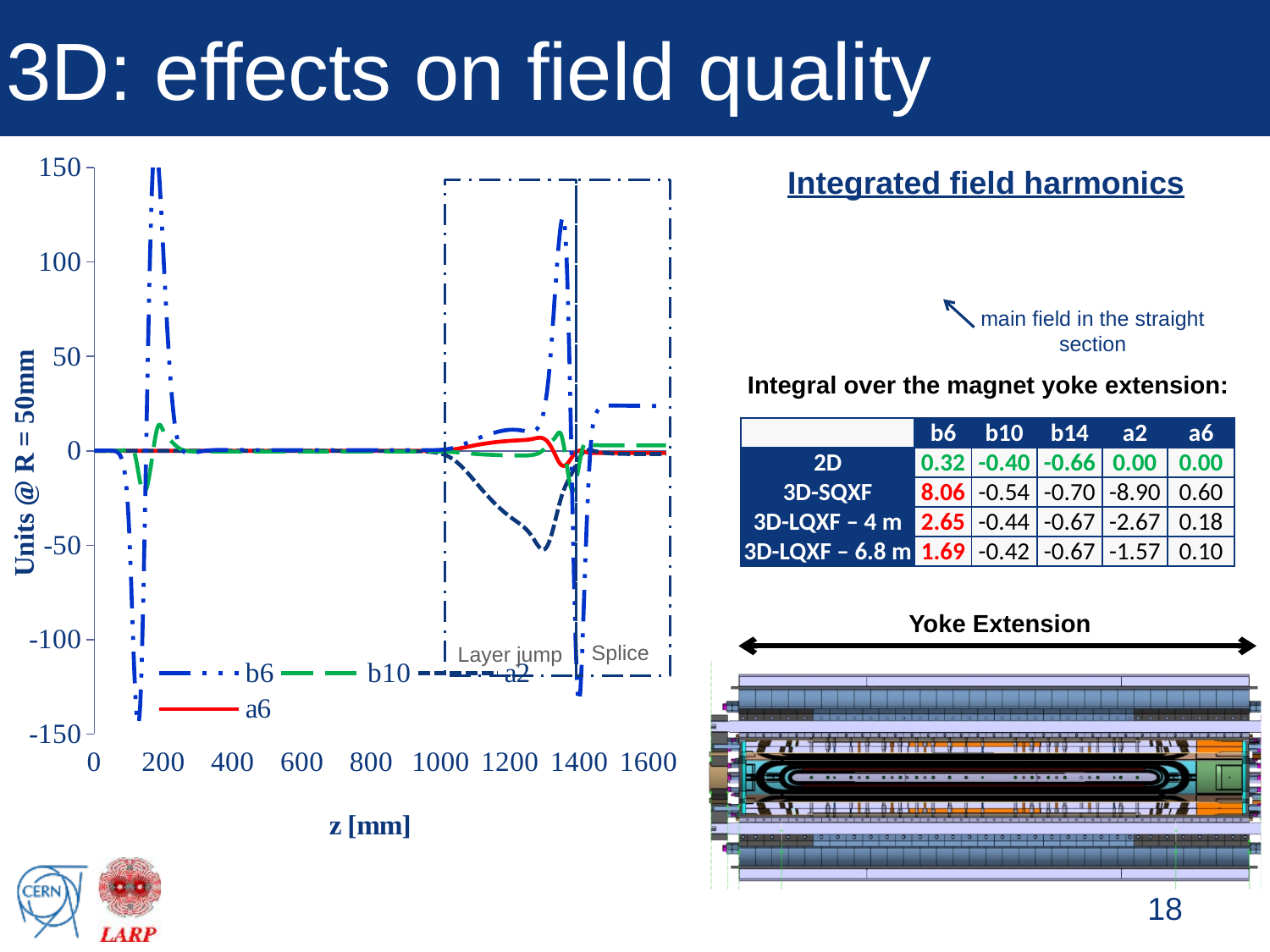
How many series does the legend of the chart list? 4 What kind of chart is shown on the left of the slide? line chart What is the label of the y axis of the chart? Units @ R = 50mm Which series has a larger magnitude peak near z = 1350 mm, b6 or a6? b6 Which series reaches the highest value on the chart? b6 Is the value of a2 at z = 1300 mm greater or less than 0? less Between z = 400 mm and z = 1000 mm, does the b6 curve stay near 0 or show large peaks? stays near 0 Is the peak value of b6 near z = 200 mm greater or less than 100? greater What is the label of the x axis of the chart? z [mm] Which series reaches the lowest value on the chart? b6 Is the minimum value of b6 near z = 1400 mm greater or less than -100? less